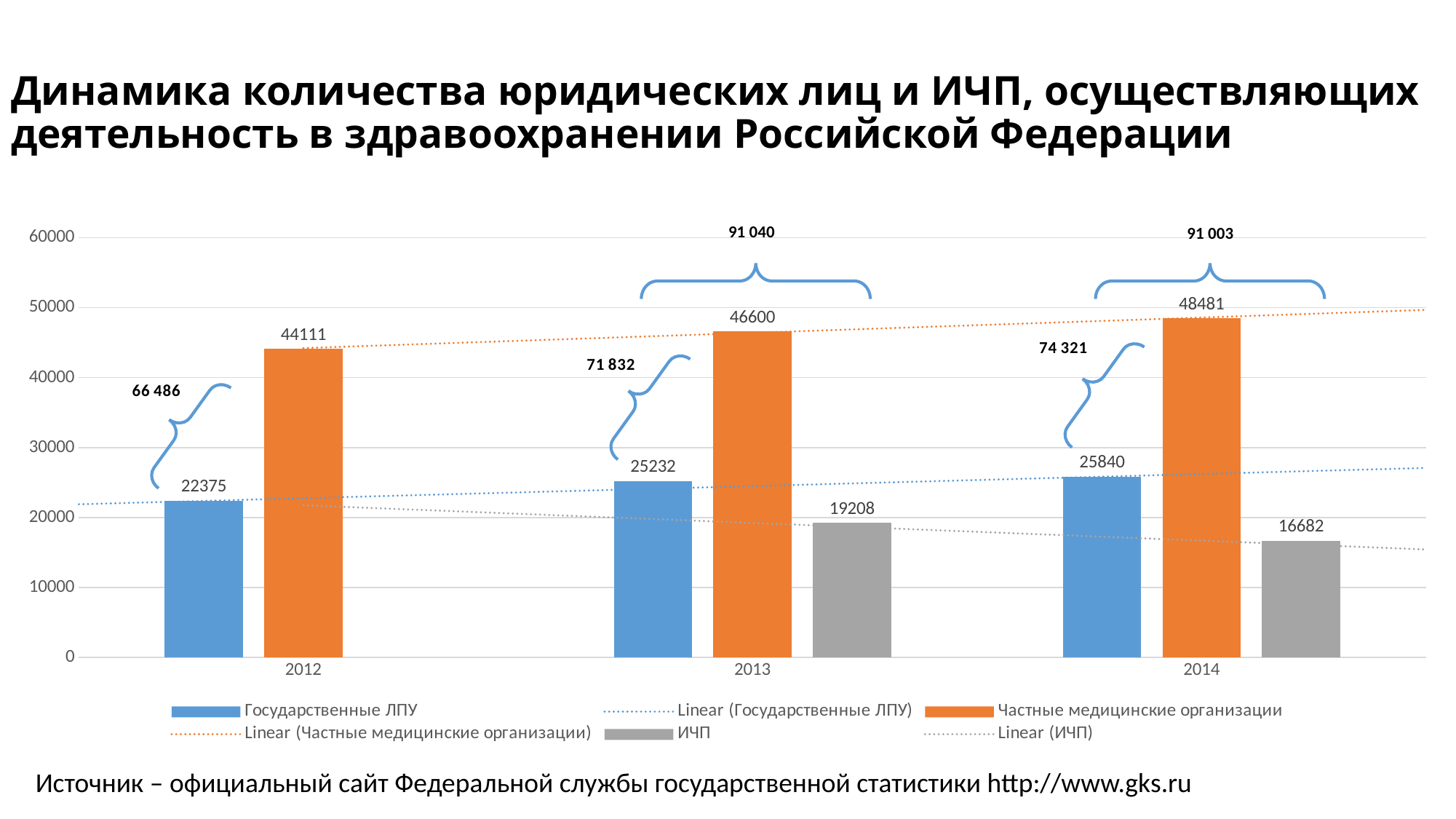
In which year is the value for Частные медицинские организации highest? 2014 What kind of chart is shown on the slide? bar chart Is the value for Частные медицинские организации in 2013 greater or less than 40000? greater How many entries does the legend list? 6 What is the value for Частные медицинские организации in 2014? 48481 What is the value for ИЧП in 2013? 19208 Which is larger in 2014: the value for Государственные ЛПУ or the value for ИЧП? Государственные ЛПУ Do the values for ИЧП rise or fall from 2013 to 2014? fall In which year is the value for Государственные ЛПУ lowest? 2012 How many years are shown on the x axis? 3 What is the value for Государственные ЛПУ in 2012? 22375 What is the difference between the Частные медицинские организации values in 2014 and 2013? 1881